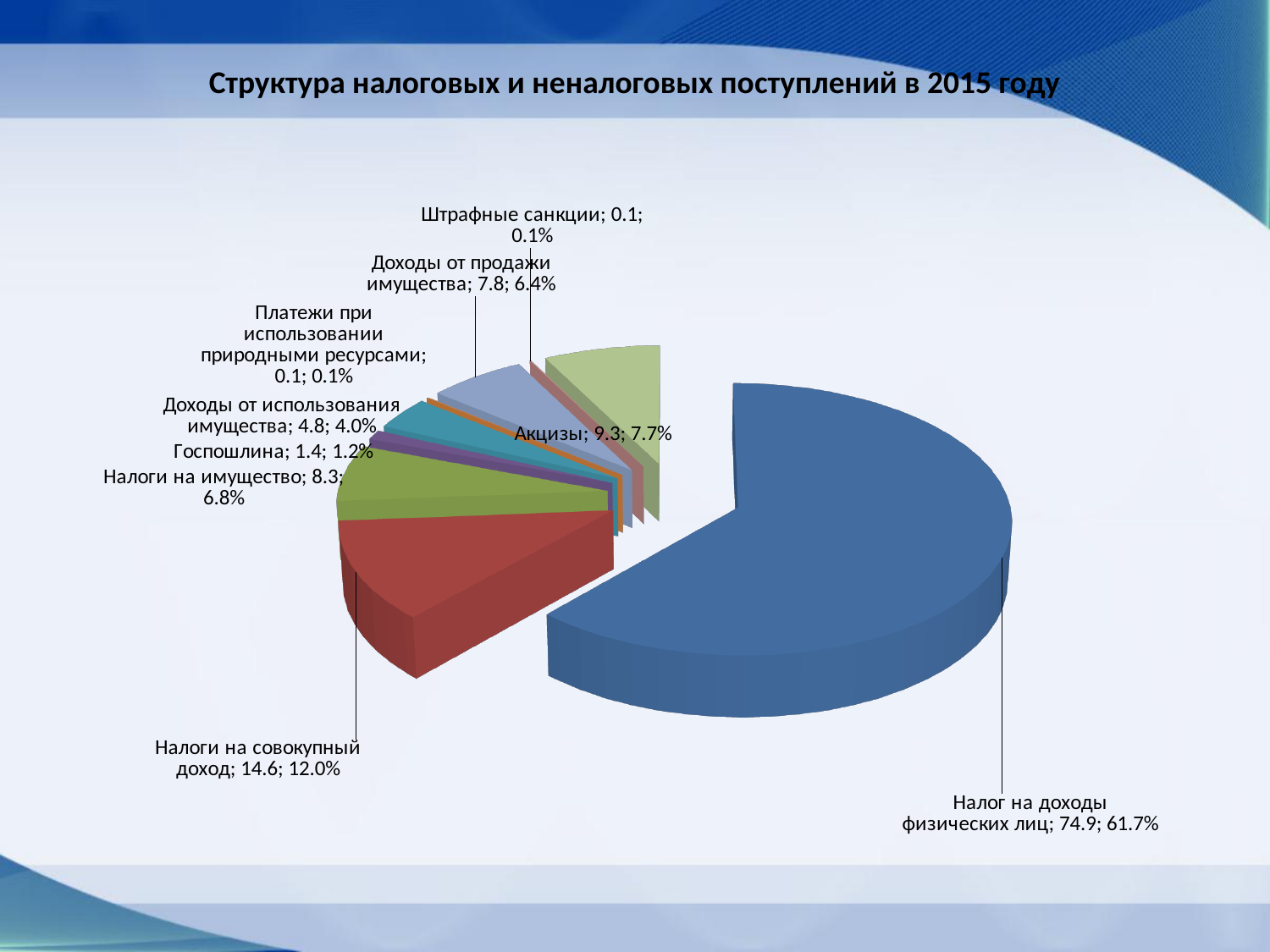
What share of the pie does Налог на доходы физических лиц represent? 61.7% What is the value shown for Доходы от продажи имущества? 7.8 What share of the pie does Госпошлина represent? 1.2% What is the value shown for Налоги на совокупный доход? 14.6 What is the difference between the values for Налоги на совокупный доход and Акцизы? 5.3 Which is larger, the value for Налоги на имущество or the value for Доходы от использования имущества? Налоги на имущество How many categories (slices) does the pie chart have? 9 What kind of chart is shown on the slide? pie chart What is the title of the chart? Структура налоговых и неналоговых поступлений в 2015 году What is the value shown for Налог на доходы физических лиц? 74.9 What share of the pie does Акцизы represent? 7.7% Which category has the largest slice of the pie? Налог на доходы физических лиц